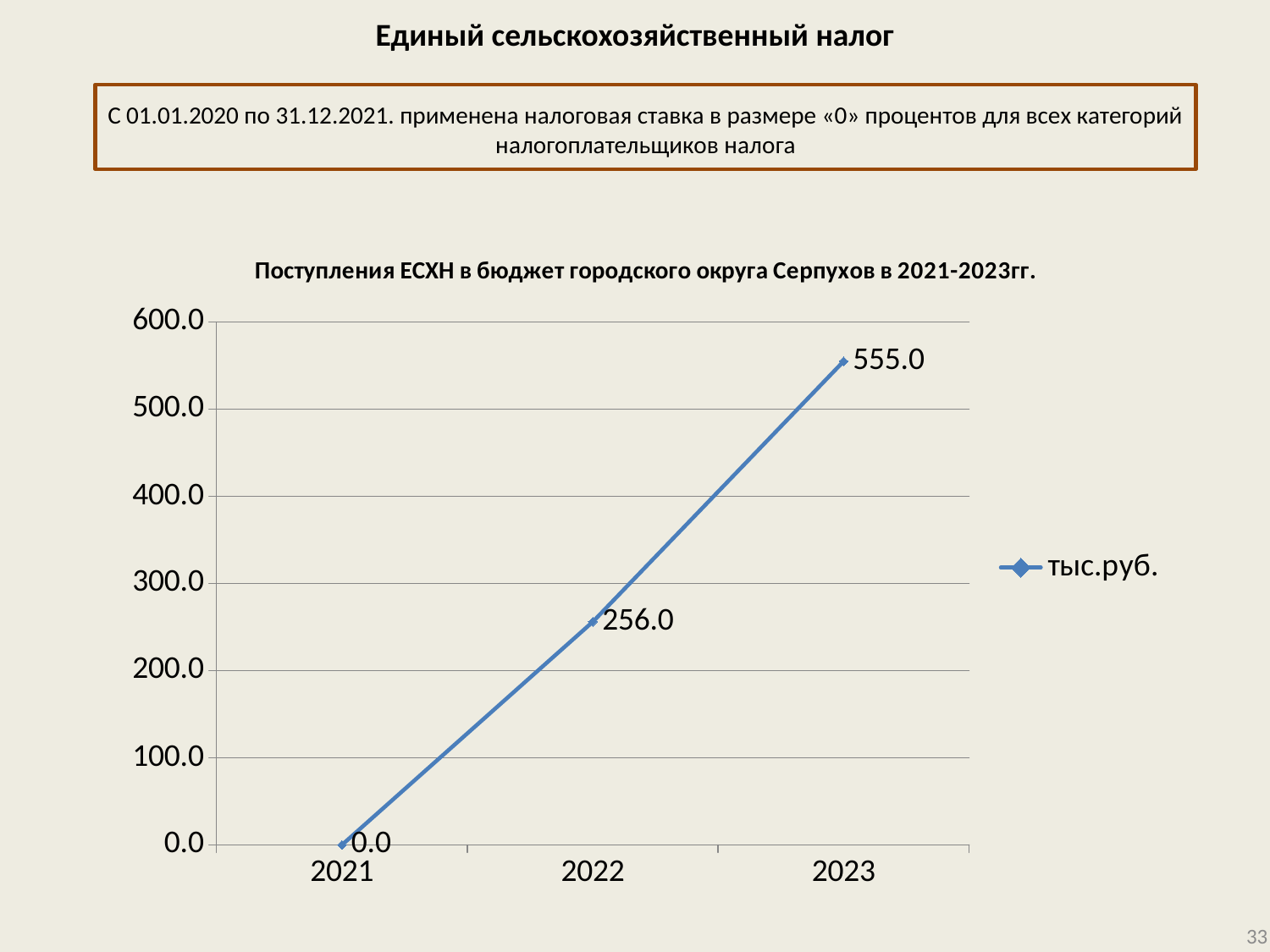
What is the difference between the values for 2023 and 2022? 299.0 What kind of chart is shown? line chart Which year has the highest value? 2023 What is the value for 2022? 256.0 Do the values rise or fall from 2021 to 2023? rise Which year has the lowest value? 2021 Which is larger, the value for 2022 or the value for 2023? 2023 What is the value for 2023? 555.0 How many series does the legend list? 1 What is the value for 2021? 0.0 Is the value for 2022 greater or less than 300.0? less How many years are plotted on the x axis? 3